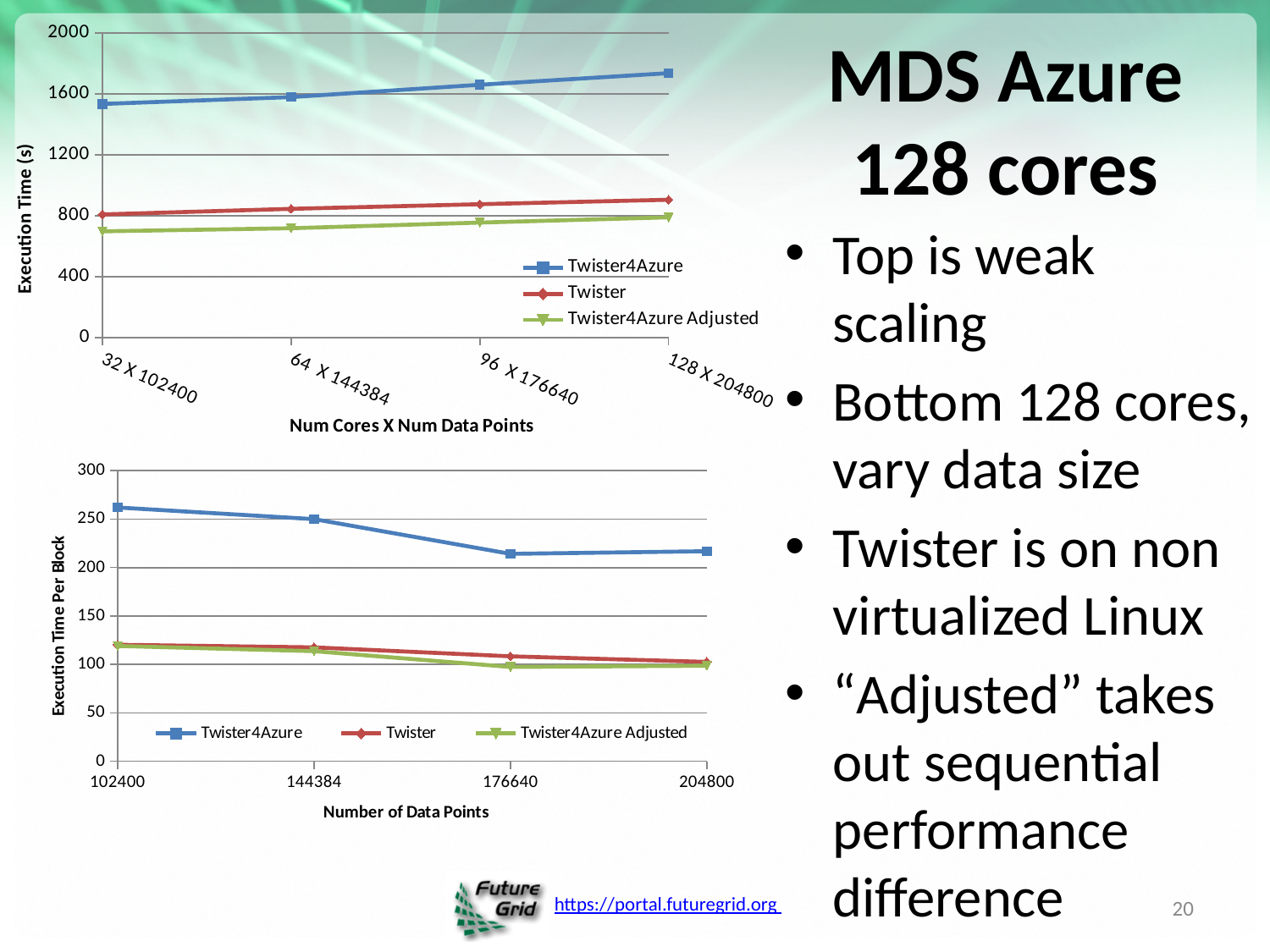
In the top chart, which series has the lowest execution time at 64 X 144384? Twister4Azure Adjusted In the bottom chart, does the Twister4Azure series rise or fall from 102400 to 176640 data points? fall In the bottom chart, which is larger at 204800 data points: the Twister4Azure value or the Twister value? Twister4Azure What kind of chart is the top chart on the slide? line chart In the top chart, which series has the highest execution time at 96 X 176640? Twister4Azure In the bottom chart, is the Twister4Azure value at 102400 data points greater or less than 250? greater In the top chart, is the Twister4Azure value at 128 X 204800 greater or less than 1600? greater How many series does the legend of the top chart list? 3 In the top chart, is the Twister4Azure Adjusted value at 32 X 102400 greater or less than 800? less How many categories are shown on the x axis of the top chart? 4 What is the x-axis title of the bottom chart? Number of Data Points In the top chart, does the Twister4Azure series rise or fall from left to right along the x axis? rise